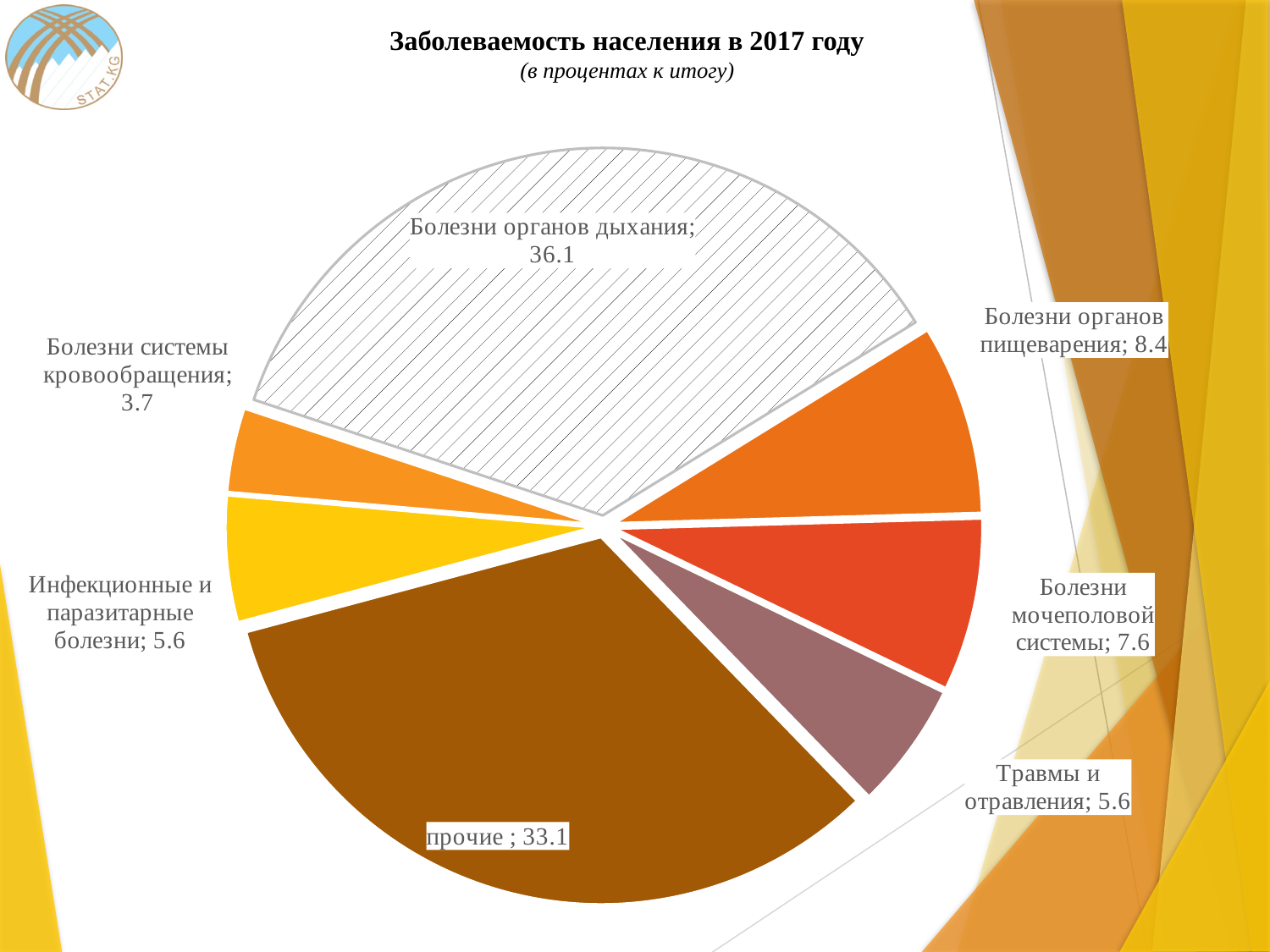
How many slices does the pie chart have? 7 What is the value for Травмы и отравления? 5.6 What is the difference between the values for Болезни органов дыхания and прочие? 3.0 Which category has the largest slice of the pie? Болезни органов дыхания Which category has the smallest slice of the pie? Болезни системы кровообращения What is the value for Болезни органов пищеварения? 8.4 What is the value for Болезни системы кровообращения? 3.7 What type of chart is shown on the slide? pie chart Which is larger, the value for Болезни органов пищеварения or the value for Болезни мочеполовой системы? Болезни органов пищеварения What is the value for Болезни органов дыхания? 36.1 What is the value for Болезни мочеполовой системы? 7.6 What is the title of the chart? Заболеваемость населения в 2017 году